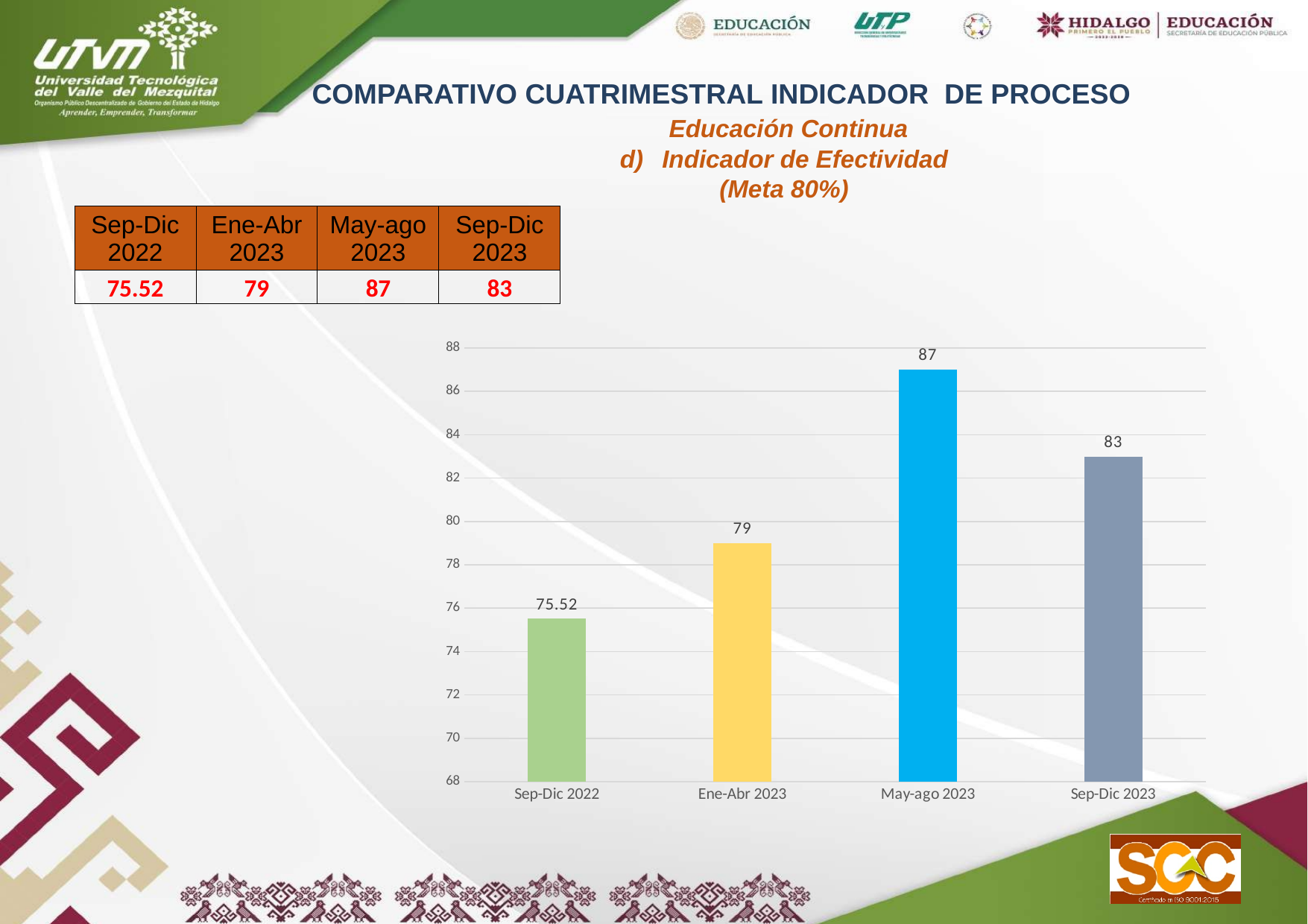
What is the value for Sep-Dic 2023? 83 Which is larger, the value for Sep-Dic 2023 or the value for Ene-Abr 2023? Sep-Dic 2023 What is the difference between the values for May-ago 2023 and Ene-Abr 2023? 8 Which period has the lowest value? Sep-Dic 2022 What is the value for May-ago 2023? 87 What colour is the bar for May-ago 2023? blue How many periods are shown on the chart? 4 What kind of chart is shown on the slide? bar chart Do the values rise or fall from Sep-Dic 2022 to May-ago 2023? rise Is the value for Ene-Abr 2023 greater or less than 80? less Which period has the highest value? May-ago 2023 What is the value for Sep-Dic 2022? 75.52